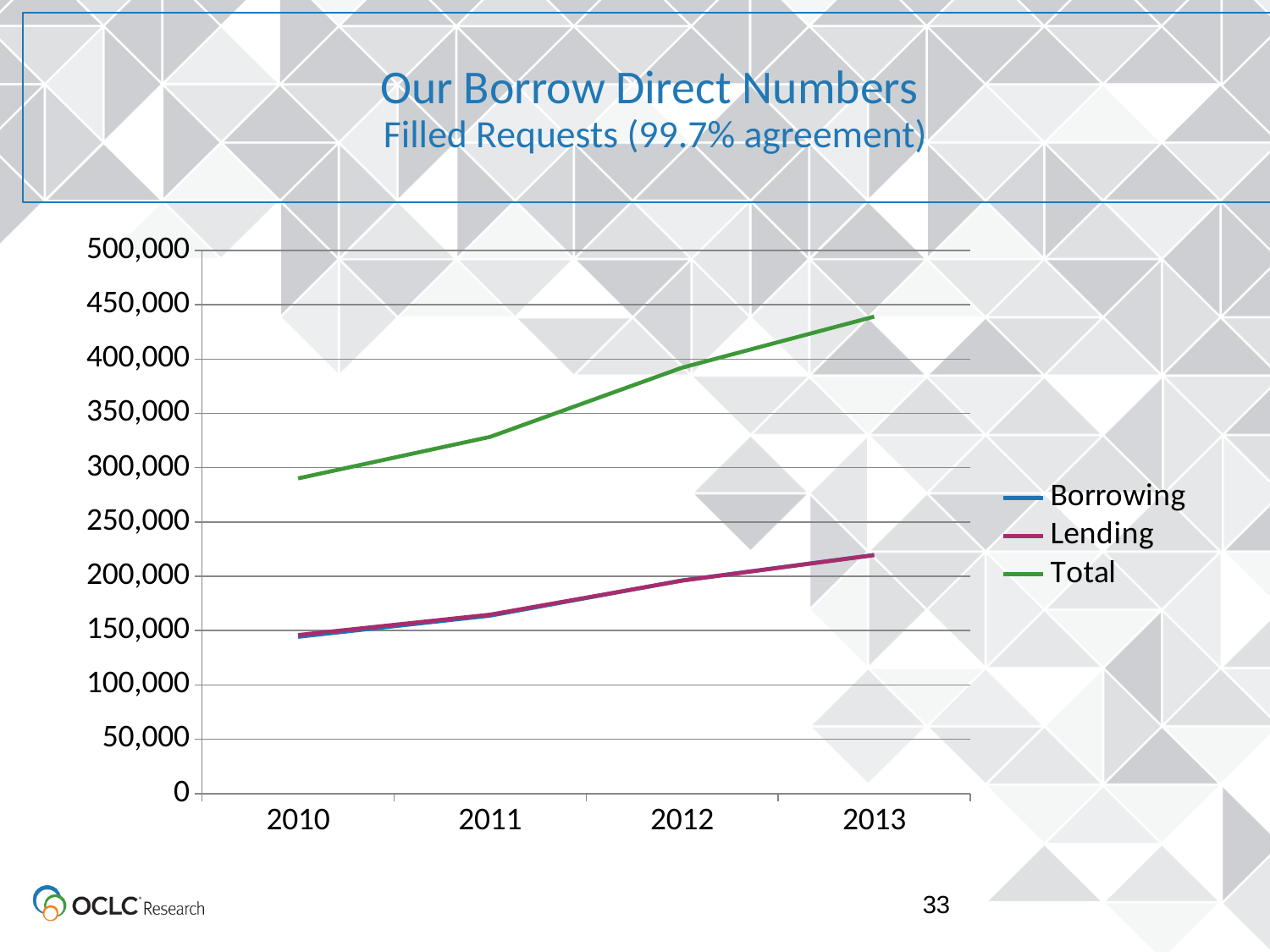
Is the Total value for 2010 greater or less than 300,000? less In which year is the Total series lowest? 2010 In which year is the Total series highest? 2013 How many series does the legend list? 3 Does the Total series rise or fall from 2010 to 2013? rise How many years are shown on the x axis? 4 What kind of chart is shown on the slide? line chart Is the Lending value for 2013 greater or less than 200,000? greater Is the Total value for 2013 greater or less than 400,000? greater In 2012, which is larger, the Total value or the Lending value? Total What colour is the Total line in the legend? green